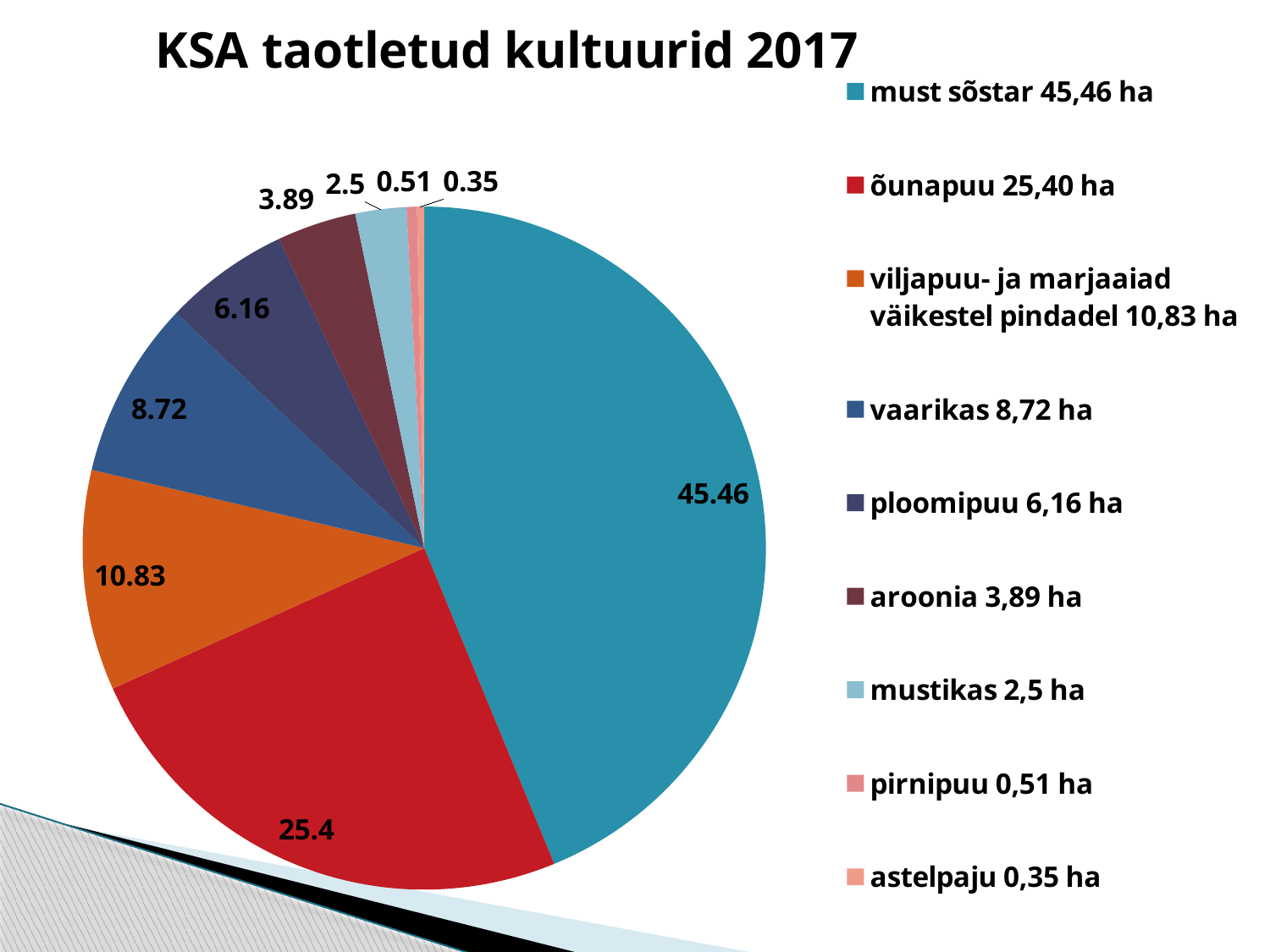
What is the difference between the values for viljapuu- ja marjaaiad väikestel pindadel and vaarikas? 2.11 What is the value shown for must sõstar? 45.46 What is the value shown for vaarikas? 8.72 Which category has the largest slice of the pie? must sõstar What kind of chart is shown on the slide? pie chart What is the value shown for õunapuu? 25.4 What is the value shown for mustikas? 2.5 What is the title of the chart? KSA taotletud kultuurid 2017 Which category has the smallest slice of the pie? astelpaju How many categories does the pie chart have? 9 Which is larger, the value for ploomipuu or the value for aroonia? ploomipuu What is the difference between the values for must sõstar and õunapuu? 20.06